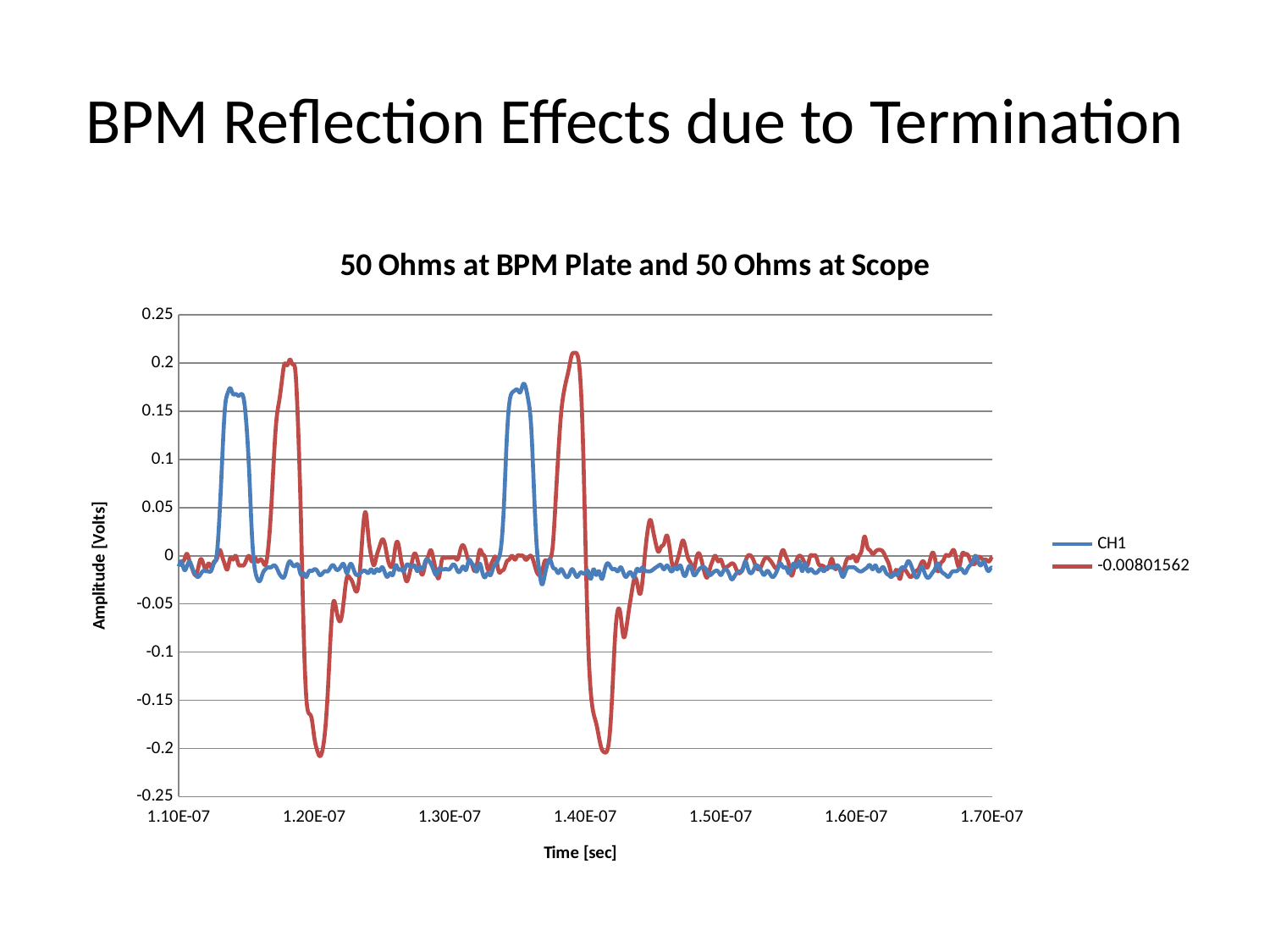
Is the peak of the -0.00801562 series near 1.40E-07 seconds greater or less than 0.2? greater What kind of chart is shown on the slide? Line chart Is the lowest value of the -0.00801562 series greater or less than -0.15? less What is the maximum value shown on the vertical axis? 0.25 Which series reaches the lowest amplitude on the chart? -0.00801562 How many series does the legend list? 2 Is the highest peak of the CH1 series greater or less than 0.15? greater What is the title of the chart? 50 Ohms at BPM Plate and 50 Ohms at Scope Which series reaches the higher peak amplitude, CH1 or -0.00801562? -0.00801562 What is the label of the vertical axis? Amplitude [Volts]